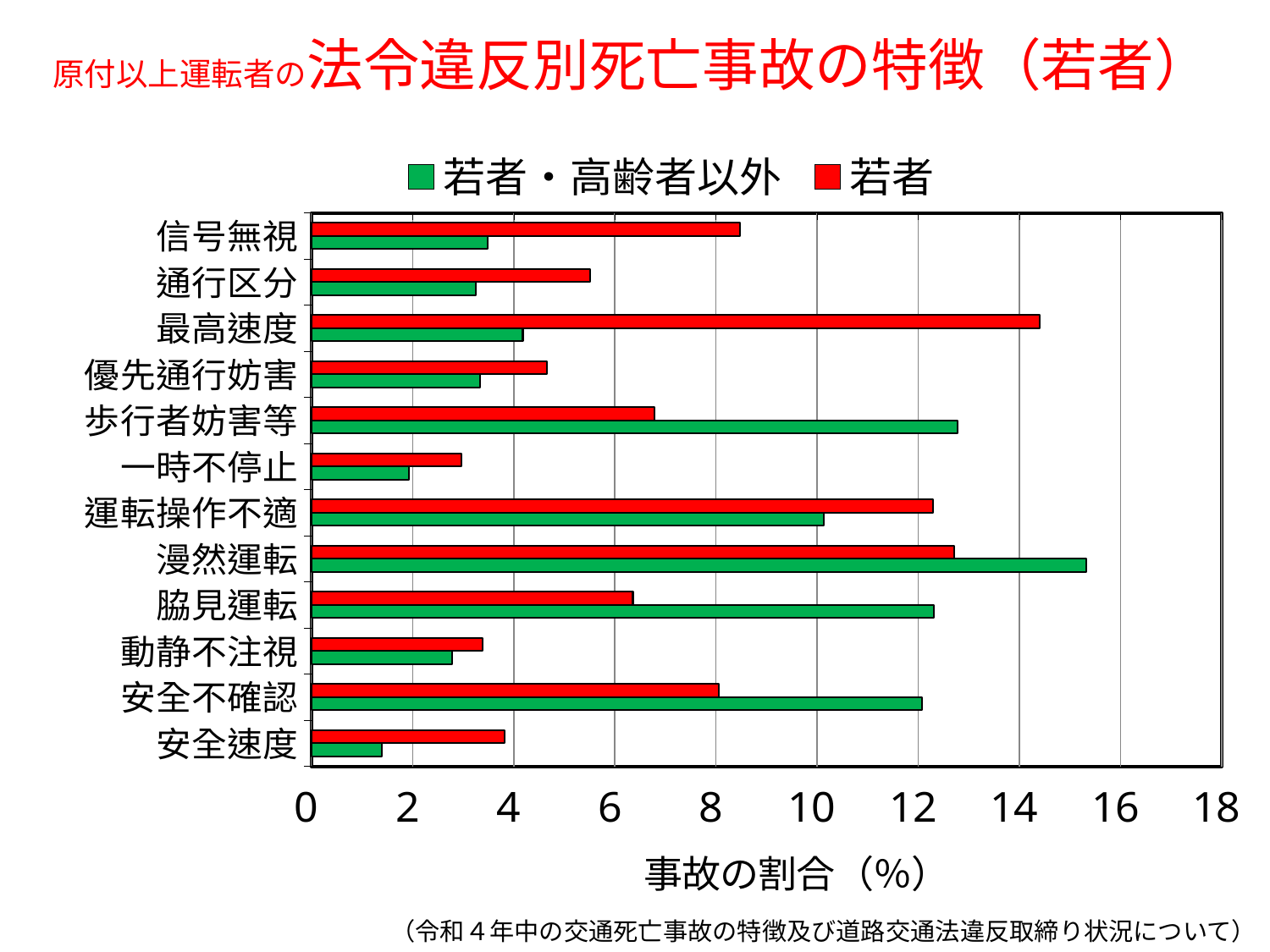
Which category has the highest value for the 若者 series? 最高速度 Which colour represents the 若者 series in the chart? red Is the 若者 value for 最高速度 greater or less than 12? greater What kind of chart is shown on the slide? bar chart Which category has the lowest value for the 若者・高齢者以外 series? 安全速度 What is the title of the horizontal axis of the chart? 事故の割合（%） Is the 若者・高齢者以外 value for 安全速度 greater or less than 2? less How many series does the chart legend list? 2 For 漫然運転, which series has the larger value, 若者 or 若者・高齢者以外? 若者・高齢者以外 For 最高速度, which series has the larger value, 若者 or 若者・高齢者以外? 若者 Which category has the highest value for the 若者・高齢者以外 series? 漫然運転 How many violation categories are listed on the vertical axis of the chart? 12